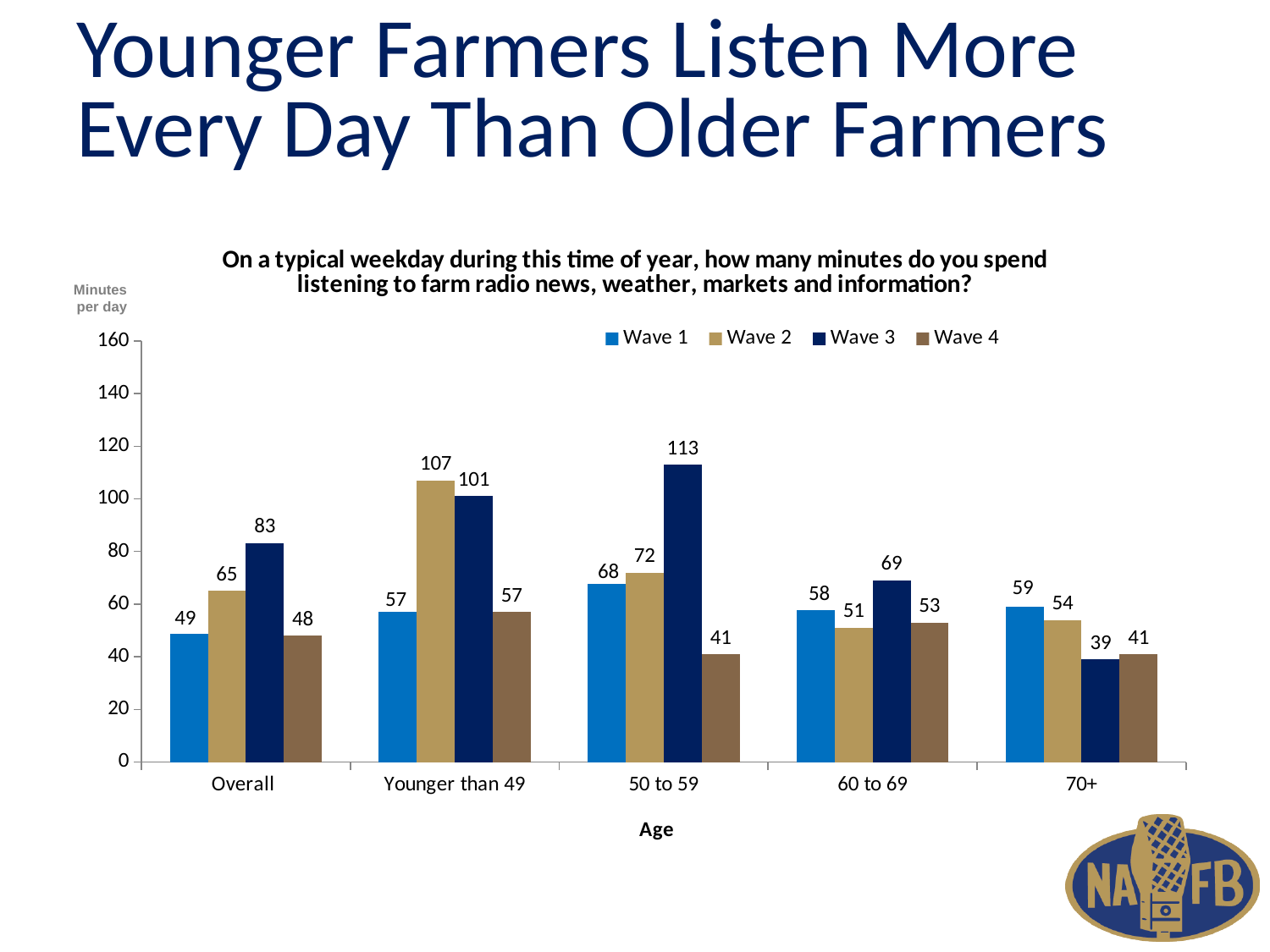
How many age categories are shown on the x axis? 5 What kind of chart is shown on the slide? bar chart Which is larger for the 70+ group, the Wave 1 value or the Wave 2 value? Wave 1 Which age category has the lowest Wave 3 value? 70+ What is the Wave 2 value for Younger than 49? 107 What is the Wave 3 value for the 50 to 59 age group? 113 Is the Wave 2 value for Younger than 49 greater or less than 100? greater What is the difference between the Wave 3 and Wave 4 values for 50 to 59? 72 What is the Wave 4 value for the Overall category? 48 How many series does the legend list? 4 What is the label of the vertical axis? Minutes per day Which age category has the highest Wave 3 value? 50 to 59